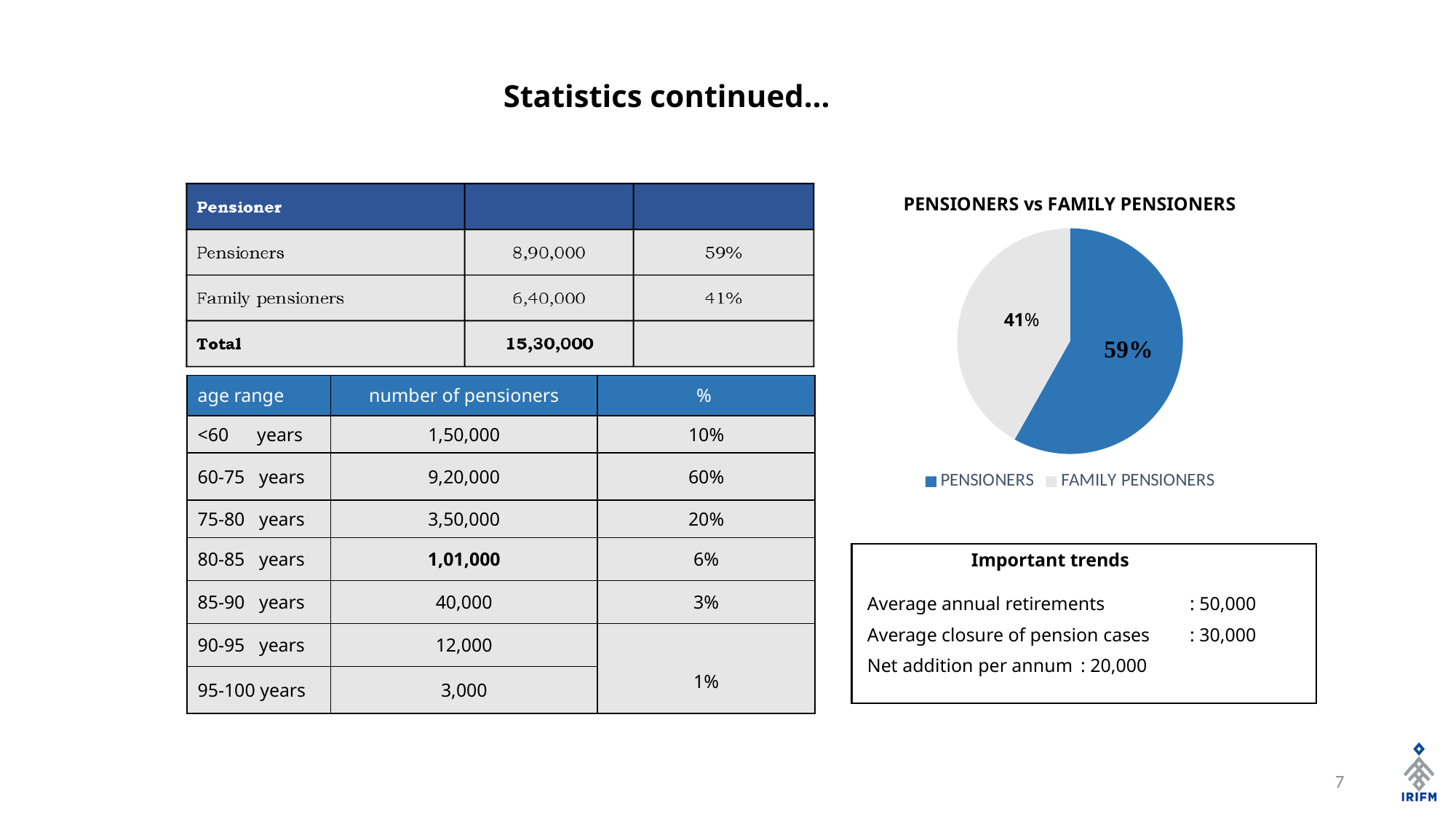
Is the share for PENSIONERS greater or less than 50%? greater How many entries does the chart legend list? 2 What colour is the PENSIONERS slice in the pie chart? blue Which slice of the pie chart is the smallest? FAMILY PENSIONERS What share of the pie does PENSIONERS take? 59% What share of the pie does FAMILY PENSIONERS take? 41% By how many percentage points does the PENSIONERS slice exceed the FAMILY PENSIONERS slice? 18 How many slices does the pie chart have? 2 What kind of chart is shown on the slide? pie chart What is the title of the chart? PENSIONERS vs FAMILY PENSIONERS Which is larger in the pie chart, PENSIONERS or FAMILY PENSIONERS? PENSIONERS Which slice of the pie chart is the largest? PENSIONERS